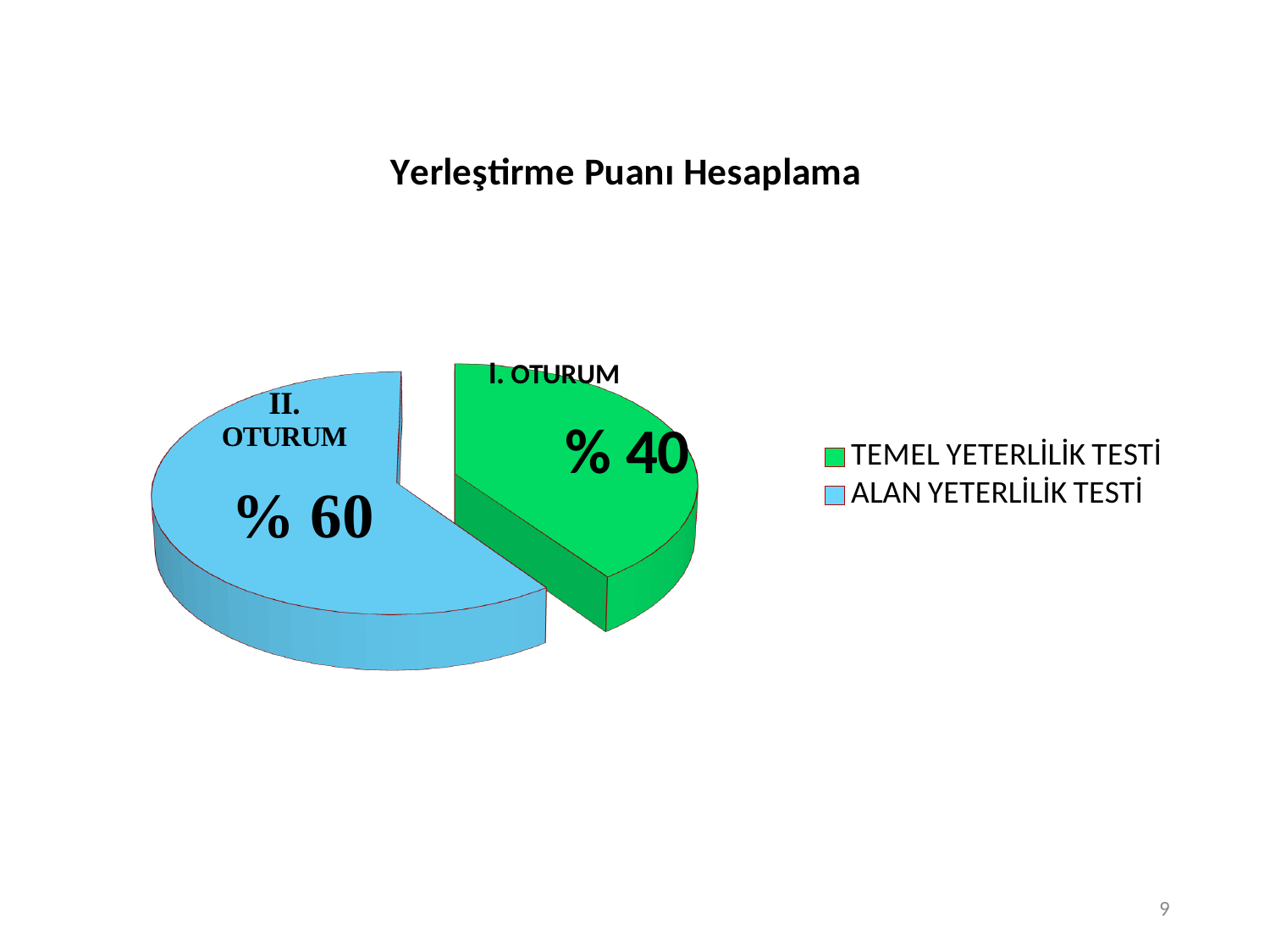
What is the difference in percentage points between the II. OTURUM slice and the I. OTURUM slice? 20 What share of the pie does TEMEL YETERLİLİK TESTİ (I. OTURUM) have? % 40 Which slice is the smallest? TEMEL YETERLİLİK TESTİ (I. OTURUM) How many entries does the legend list? 2 Which slice is the largest? ALAN YETERLİLİK TESTİ (II. OTURUM) What kind of chart is shown on the slide? pie chart What share of the pie does ALAN YETERLİLİK TESTİ (II. OTURUM) have? % 60 Is the share for I. OTURUM greater or less than 50%? less What is the title of the chart? Yerleştirme Puanı Hesaplama How many slices does the pie chart have? 2 What colour is the ALAN YETERLİLİK TESTİ slice? light blue Which is larger, the I. OTURUM slice or the II. OTURUM slice? II. OTURUM